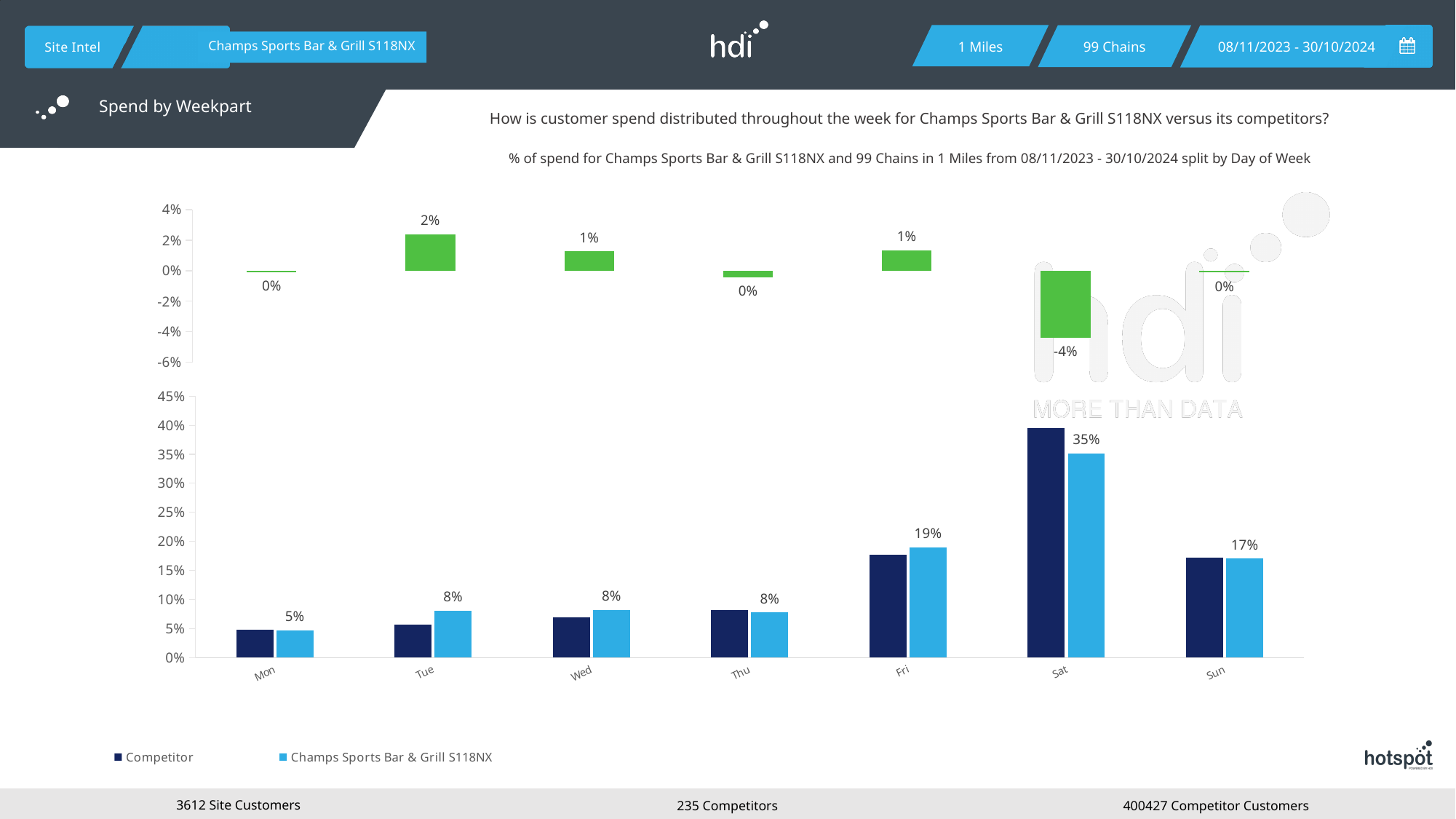
In the bottom bar chart, what is the value for Champs Sports Bar & Grill S118NX on Fri? 19% In the bottom bar chart, what is the value for Champs Sports Bar & Grill S118NX on Mon? 5% In the bottom bar chart, is the Competitor value for Sat greater or less than 35%? greater How many series does the legend of the bottom bar chart list? 2 In the bottom bar chart, what is the difference between the Champs Sports Bar & Grill S118NX values for Sat and Sun? 18% In the top chart, what is the value shown for Sat? -4% In the bottom bar chart, which day has the lowest value for Champs Sports Bar & Grill S118NX? Mon In the bottom bar chart, which is larger on Tue: the Competitor bar or the Champs Sports Bar & Grill S118NX bar? Champs Sports Bar & Grill S118NX How many days of the week are shown on the x axis of the bottom bar chart? 7 In the bottom bar chart, which day has the highest value for Champs Sports Bar & Grill S118NX? Sat In the top chart, which day has the highest value? Tue In the bottom bar chart, what is the value for Champs Sports Bar & Grill S118NX on Sat? 35%